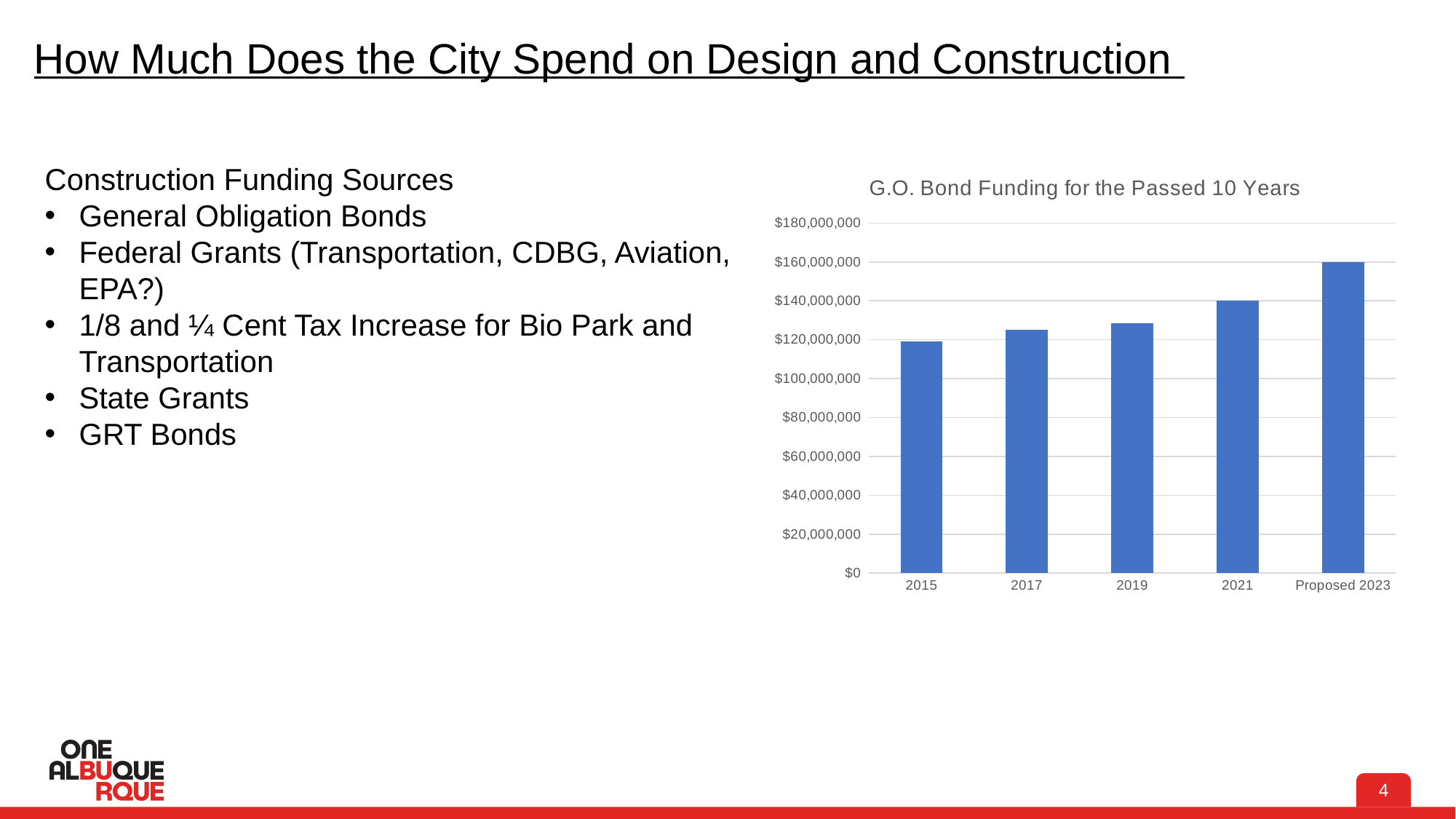
What type of chart is shown on the slide? Bar chart What is the title of the chart? G.O. Bond Funding for the Passed 10 Years Is the value for 2017 greater or less than $120,000,000? greater How many bars (categories) are shown in the chart? 5 Which is larger, the value for 2017 or the value for 2021? 2021 Which category has the highest G.O. bond funding? Proposed 2023 What is the G.O. bond funding value for Proposed 2023? $160,000,000 Is the value for 2019 greater or less than $140,000,000? less Do the values rise or fall from 2015 to Proposed 2023? Rise Is the value for 2015 greater or less than $100,000,000? greater Which year has the lowest G.O. bond funding? 2015 What is the G.O. bond funding value for 2021? $140,000,000